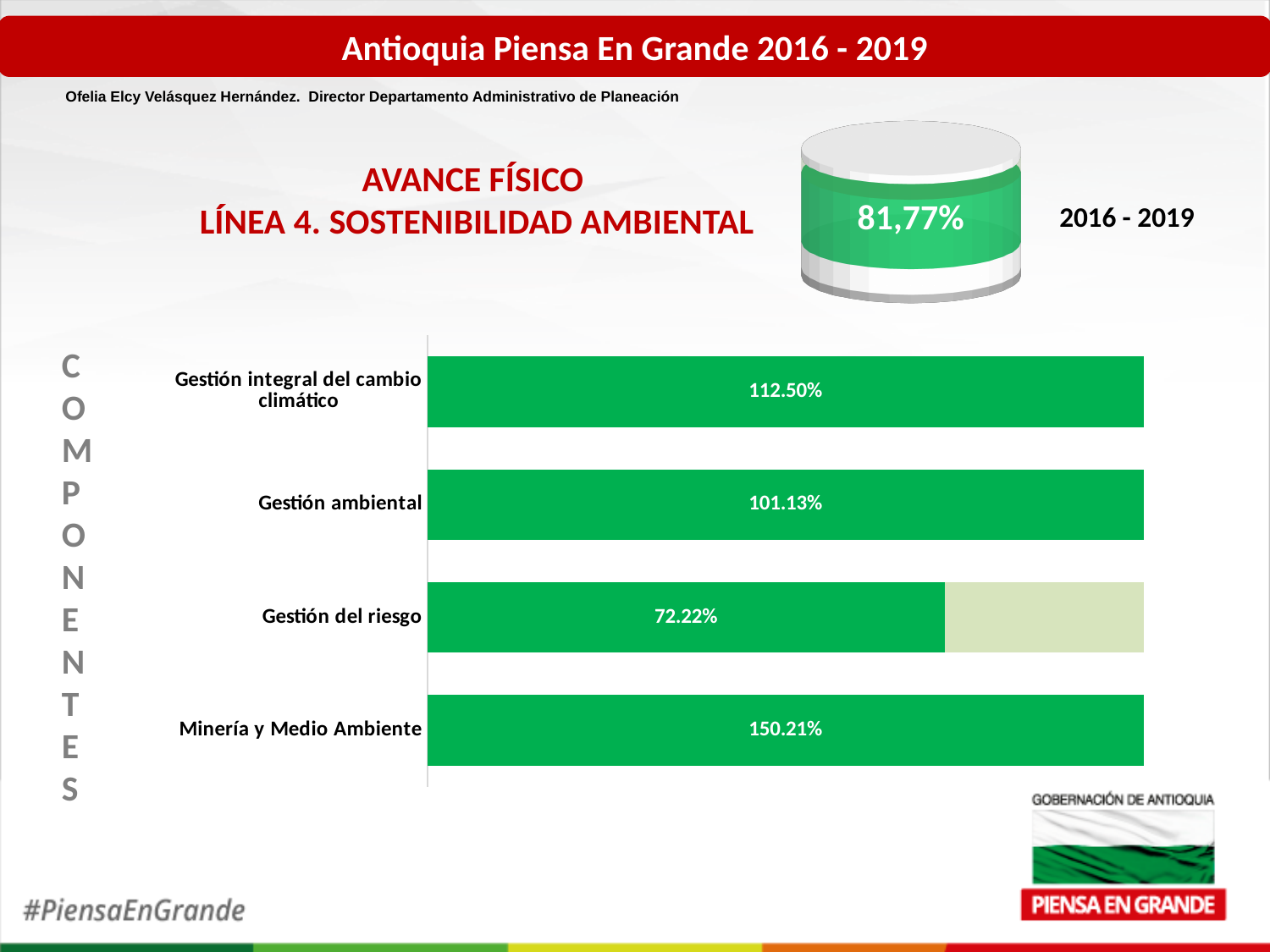
Which is larger, the value for Gestión ambiental or the value for Gestión del riesgo? Gestión ambiental What overall physical progress percentage is shown in the cylinder graphic above the chart? 81,77% What is the value for Minería y Medio Ambiente? 150.21% What is the value for Gestión integral del cambio climático? 112.50% Which component has the highest value? Minería y Medio Ambiente What is the value for Gestión del riesgo? 72.22% Which component has the lowest value? Gestión del riesgo What kind of chart is shown on the slide? Bar chart How many components are shown in the chart? 4 What is the difference between the values for Minería y Medio Ambiente and Gestión del riesgo? 77.99% What is the value for Gestión ambiental? 101.13% What is the difference between the values for Gestión integral del cambio climático and Gestión ambiental? 11.37%